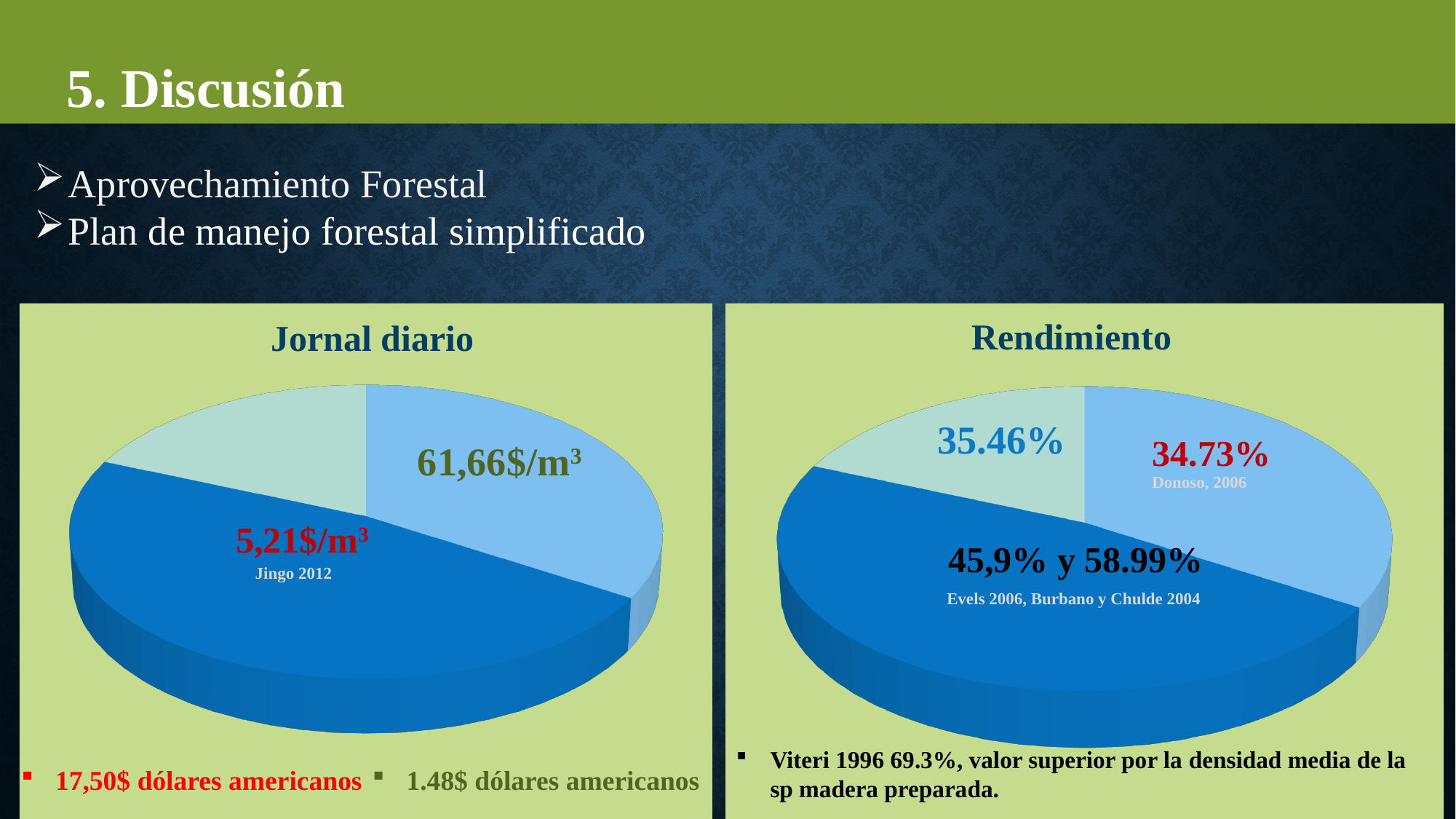
What kind of chart is the 'Rendimiento' chart? Pie chart In the 'Jornal diario' pie chart, which slice is the smallest: the dark blue, the light blue, or the pale green one? Pale green What value is printed on the light blue slice of the 'Jornal diario' pie chart? 61,66$/m³ What kind of chart is the 'Jornal diario' chart? Pie chart In the 'Rendimiento' pie chart, which slice is the smallest: the dark blue, the light blue, or the pale green one? Pale green How many slices does the 'Jornal diario' pie chart have? 3 How many slices does the 'Rendimiento' pie chart have? 3 What is the title of the pie chart on the right side of the slide? Rendimiento In the 'Jornal diario' pie chart, which slice is the largest: the dark blue, the light blue, or the pale green one? Dark blue In the 'Rendimiento' pie chart, which slice is the largest: the dark blue, the light blue, or the pale green one? Dark blue In the 'Jornal diario' pie chart, is the light blue slice larger or smaller than the pale green slice? Larger What percentage is printed on the pale green slice of the 'Rendimiento' pie chart? 35.46%